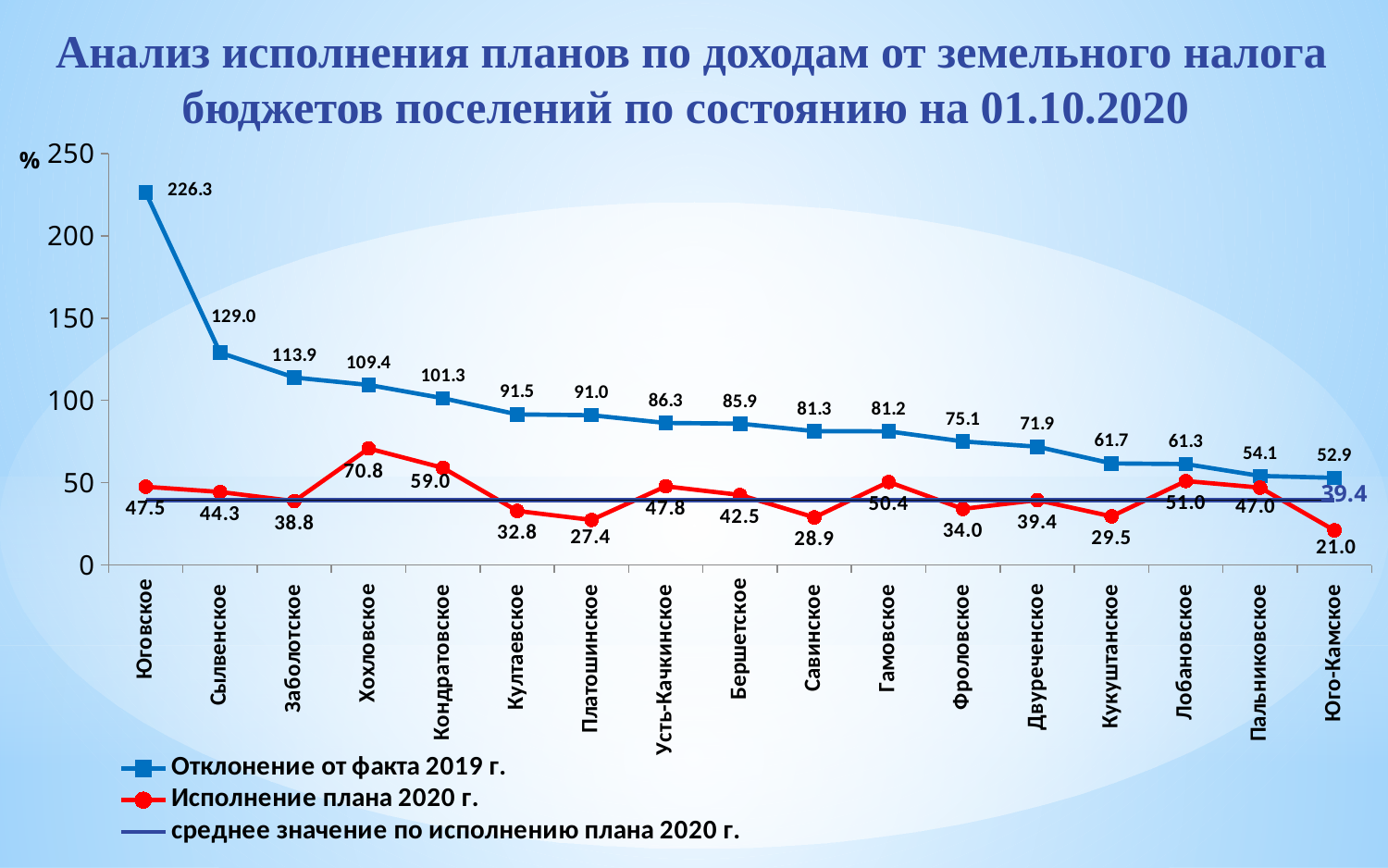
What is the value of 'Отклонение от факта 2019 г.' for Юговское? 226.3 How many series does the legend list? 3 How many settlements (categories) are plotted along the x axis? 17 What type of chart is shown on the slide? line chart Which settlement has the highest value for 'Отклонение от факта 2019 г.'? Юговское What is the value of 'Исполнение плана 2020 г.' for Платошинское? 27.4 What is the value of 'Исполнение плана 2020 г.' for Хохловское? 70.8 Does the 'Отклонение от факта 2019 г.' series rise or fall from left to right along the x axis? fall Which is larger for Гамовское: 'Отклонение от факта 2019 г.' or 'Исполнение плана 2020 г.'? Отклонение от факта 2019 г. Which settlement has the lowest value for 'Исполнение плана 2020 г.'? Юго-Камское What is the value of the line 'среднее значение по исполнению плана 2020 г.'? 39.4 What is the difference between the 'Отклонение от факта 2019 г.' values for Юговское and Сылвенское? 97.3